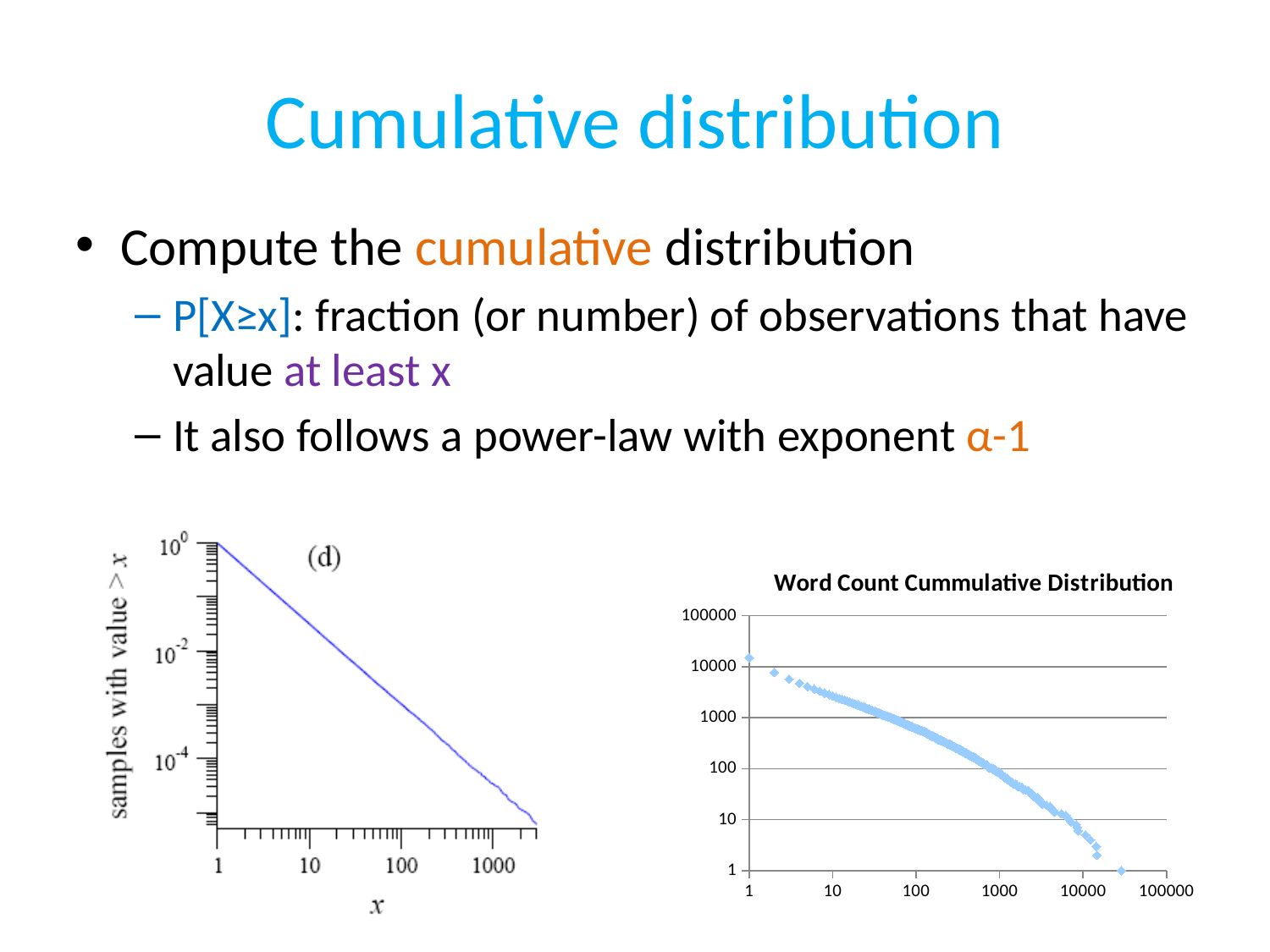
In the 'Word Count Cummulative Distribution' chart, do the values rise or fall as x increases? fall In the 'Word Count Cummulative Distribution' chart, is the value at x = 1000 greater or less than 10? greater What is the y-axis label of the chart on the left side of the slide (panel d)? samples with value > x In the 'Word Count Cummulative Distribution' chart, is the value at x = 1 greater or less than 10000? greater In the 'Word Count Cummulative Distribution' chart, is the value at x = 100 greater or less than 1000? less What kind of chart is the 'Word Count Cummulative Distribution' chart? scatter chart In the 'Word Count Cummulative Distribution' chart, which has the larger value: x = 10 or x = 10000? x = 10 In the chart on the left side of the slide (panel d), do the values rise or fall as x increases? fall What is the title of the chart on the right side of the slide? Word Count Cummulative Distribution What kind of chart is the chart on the left side of the slide (panel d)? line chart In the 'Word Count Cummulative Distribution' chart, what is the highest tick label shown on the y axis? 100000